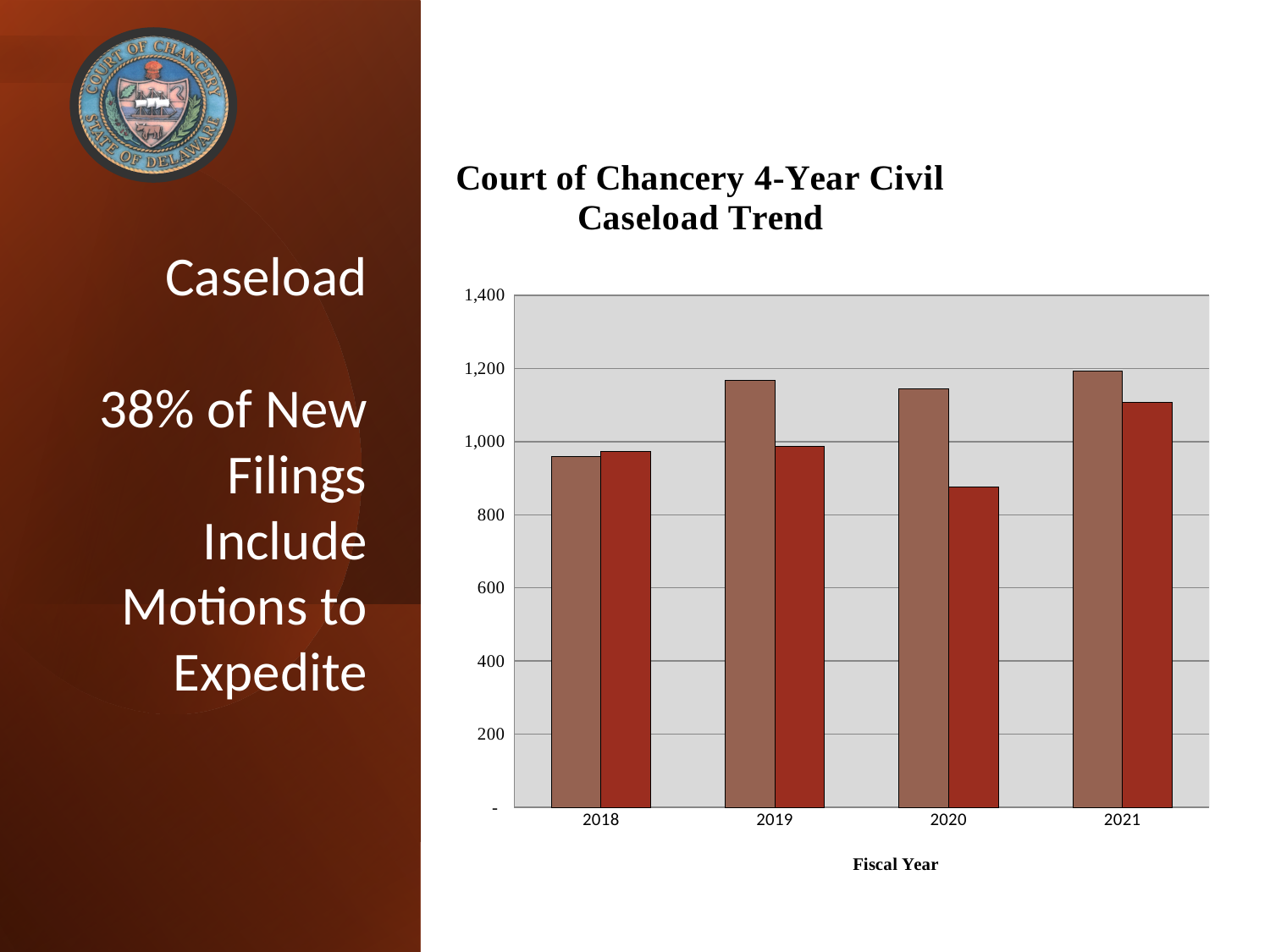
Is the value of the lighter brown bar for 2019 greater or less than 1,000? greater Is the value of the darker red bar for 2020 greater or less than 1,000? less Is the value of the lighter brown bar for 2018 greater or less than 1,000? less Among the darker red bars, which fiscal year has the highest value? 2021 What is the title of the chart? Court of Chancery 4-Year Civil Caseload Trend For 2020, which bar is larger, the lighter brown bar or the darker red bar? the lighter brown bar What is the label on the x axis of the chart? Fiscal Year Among the darker red bars, which fiscal year has the lowest value? 2020 How many fiscal years are shown on the x axis of the chart? 4 How many bars are plotted in total on the chart? 8 What kind of chart is shown on the slide? bar chart